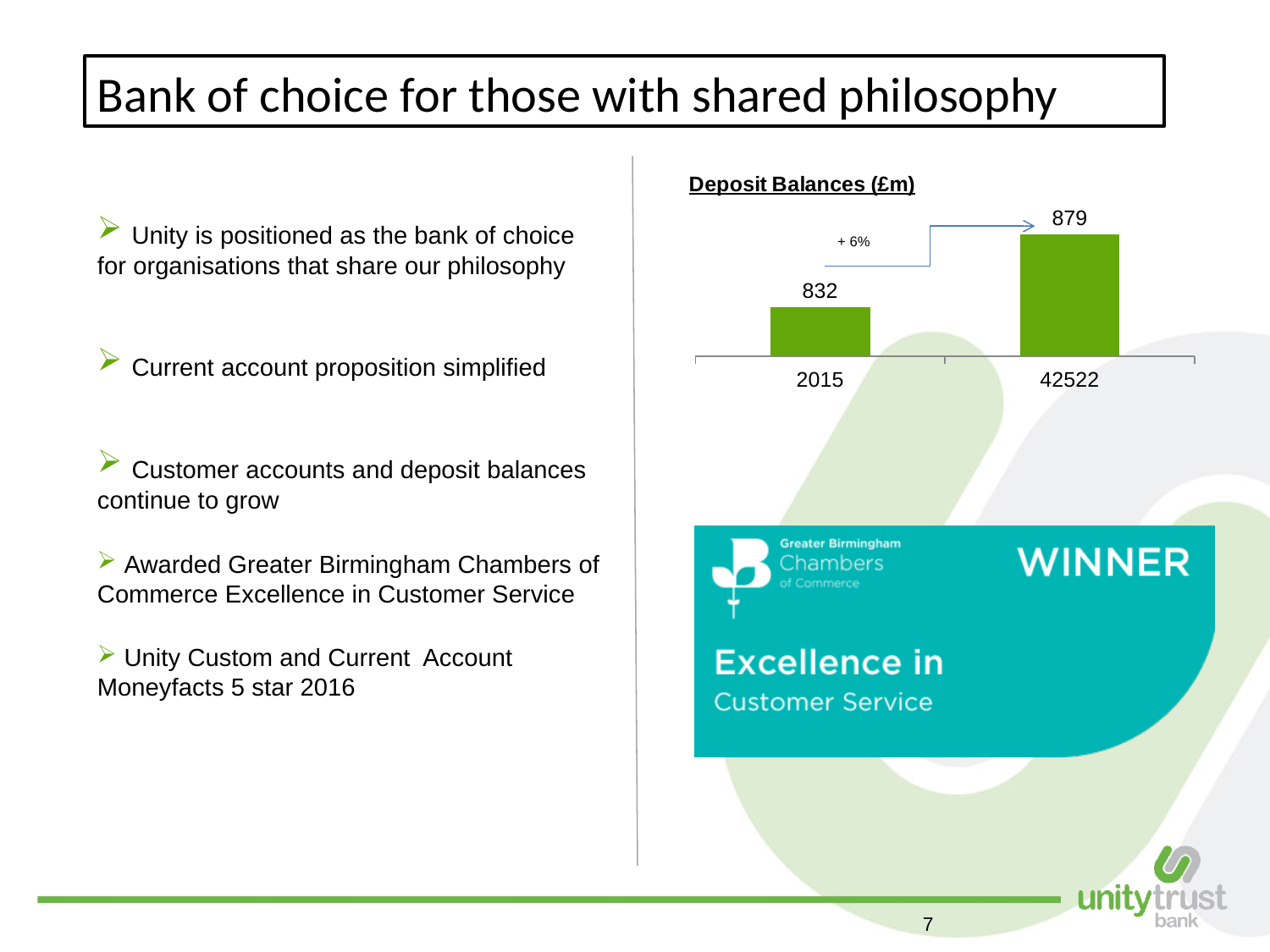
Which category has the lowest value in the Deposit Balances (£m) chart? 2015 What is the difference between the two bars in the Deposit Balances (£m) chart? 47 How many bars are shown in the Deposit Balances (£m) chart? 2 Do the values in the Deposit Balances (£m) chart rise or fall from left to right? rise What percentage change is annotated between the two bars in the Deposit Balances (£m) chart? + 6% In the Deposit Balances (£m) chart, is the value for 2015 larger or smaller than the value for 42522? smaller What kind of chart is the Deposit Balances (£m) chart? bar chart What is the deposit balance value for 2015 in the Deposit Balances (£m) chart? 832 What is the deposit balance value for the category labelled 42522 in the Deposit Balances (£m) chart? 879 Which category has the highest value in the Deposit Balances (£m) chart? 42522 What is the title of the chart on the slide? Deposit Balances (£m)